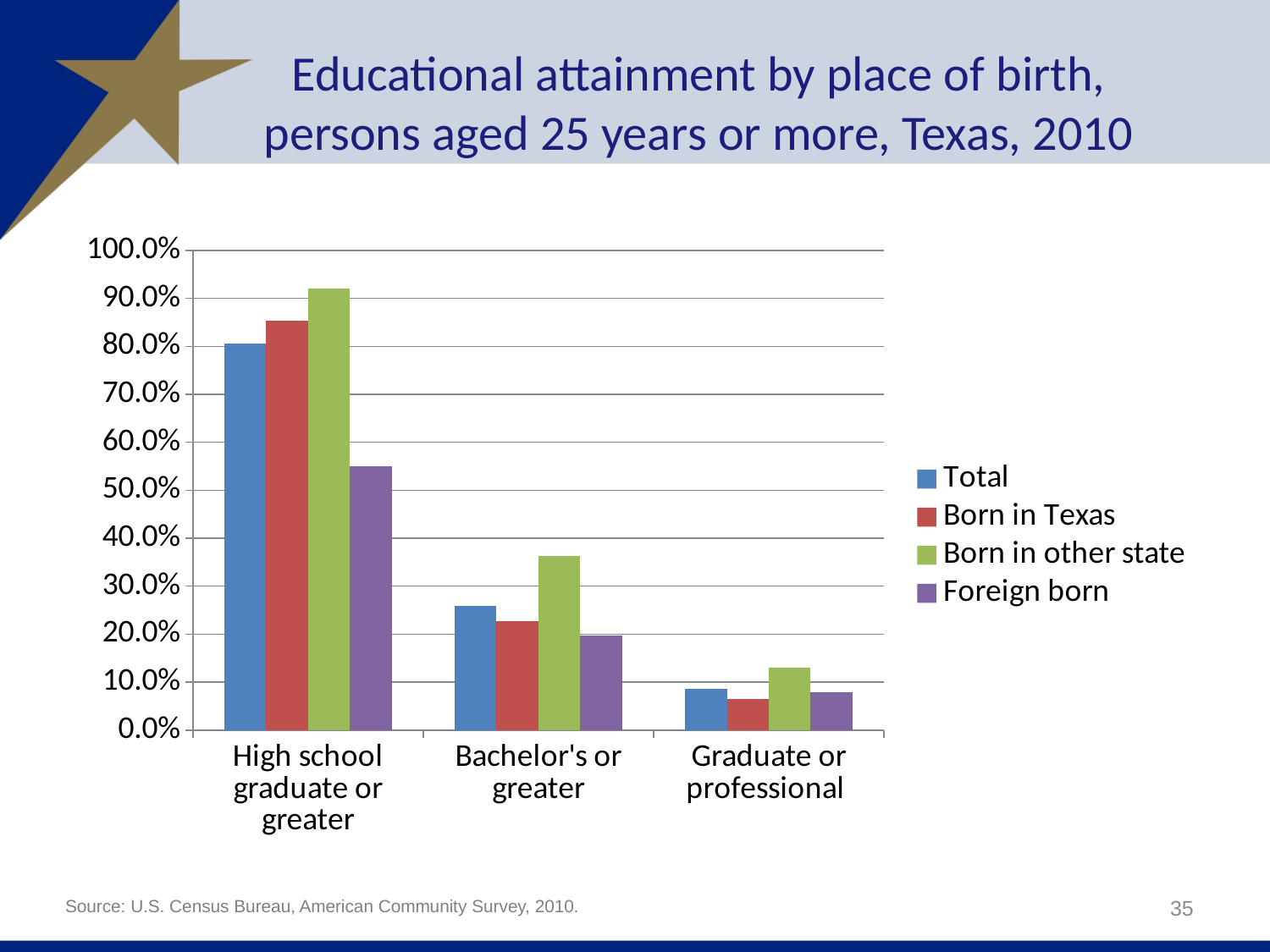
Do the values for the Total series rise or fall moving from High school graduate or greater to Graduate or professional? fall Is the value for Born in Texas in the Graduate or professional category greater or less than 10.0%? less Is the value for Foreign born in the High school graduate or greater category greater or less than 60.0%? less What type of chart is shown on the slide? bar chart Which series has the lowest value for Graduate or professional? Born in Texas How many series does the legend list? 4 Which series has the lowest value for High school graduate or greater? Foreign born Which series has the highest value for High school graduate or greater? Born in other state How many education categories are shown on the x axis? 3 Which series has the highest value for Bachelor's or greater? Born in other state Is the value for Born in other state in the Bachelor's or greater category greater or less than 30.0%? greater For Bachelor's or greater, which is larger: Total or Born in Texas? Total